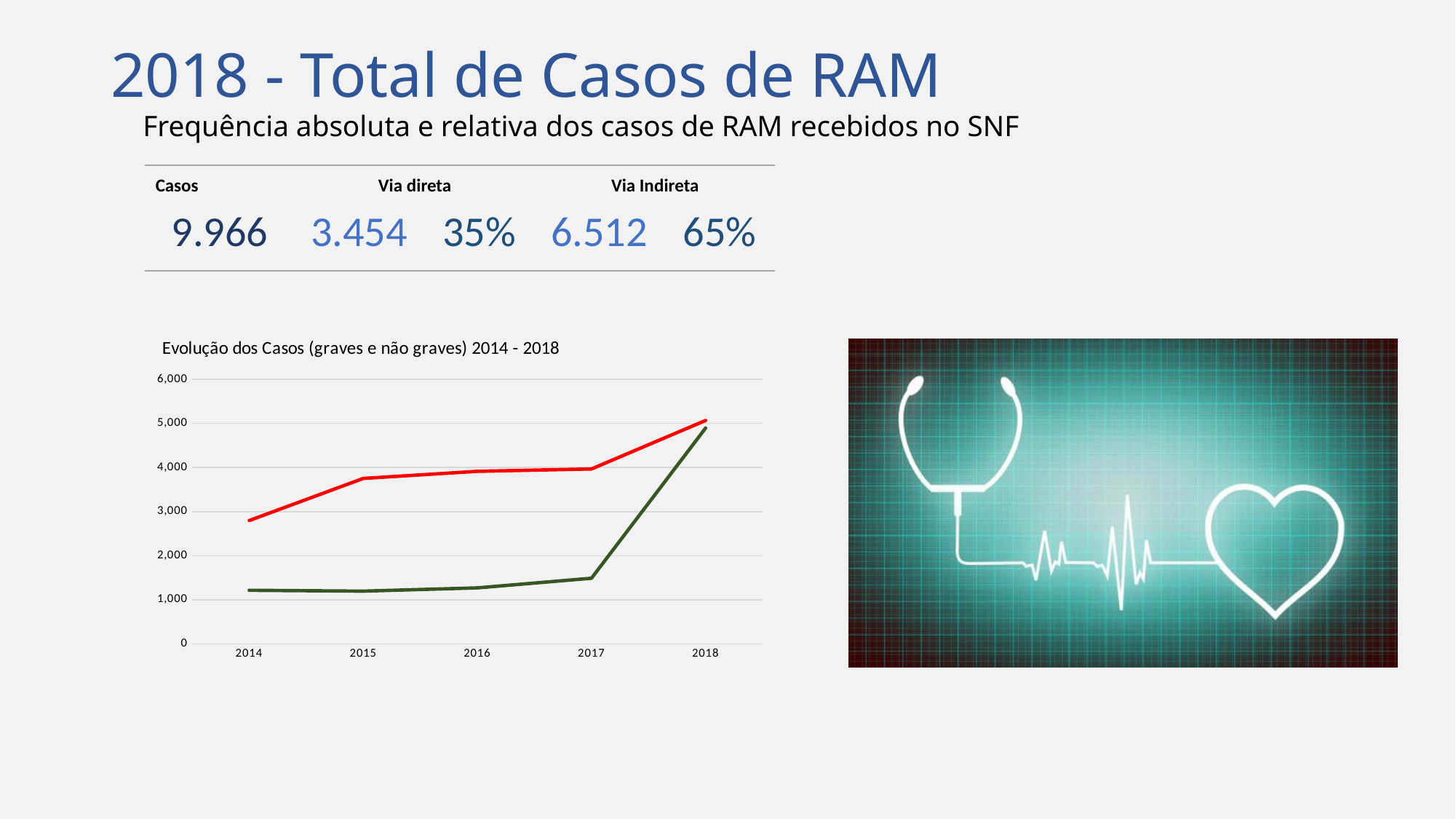
What is the title of the chart on the slide? Evolução dos Casos (graves e não graves) 2014 - 2018 Does the green line rise or fall between 2017 and 2018? rise In which year does the green line reach its highest value? 2018 In 2014, which line has the higher value, the red line or the green line? the red line What kind of chart is shown on the slide? line chart Is the value of the green line in 2018 greater or less than 4,000? greater Is the value of the green line in 2017 greater or less than 2,000? less Is the value of the red line in 2014 greater or less than 3,000? less In which year does the red line reach its highest value? 2018 How many lines are plotted in the chart? 2 How many years are plotted along the x axis of the chart? 5